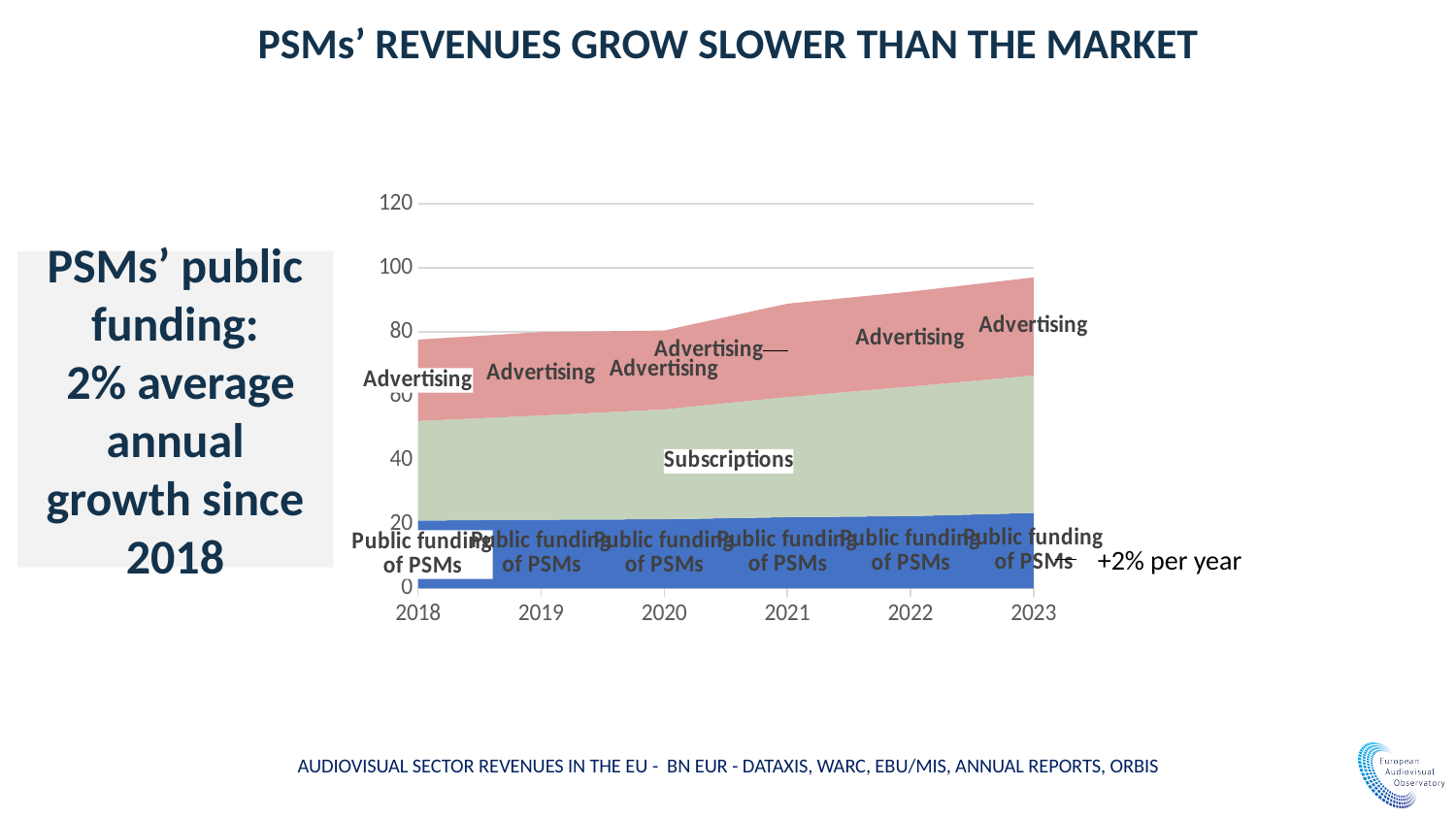
How many revenue series are stacked in the chart? 3 Is the total stacked revenue in 2021 greater or less than 80? greater Is the total stacked revenue in 2023 greater or less than 80? greater What kind of chart is shown on the slide? Stacked area chart Is the value for Public funding of PSMs in 2018 greater or less than 40? less Which year is the first on the x axis of the chart? 2018 How many years are shown along the x axis of the chart? 6 Which series forms the bottom layer of the stacked area chart? Public funding of PSMs Which three revenue categories are labelled in the chart? Public funding of PSMs, Subscriptions, Advertising Does the total stacked revenue rise or fall from 2018 to 2023? Rise